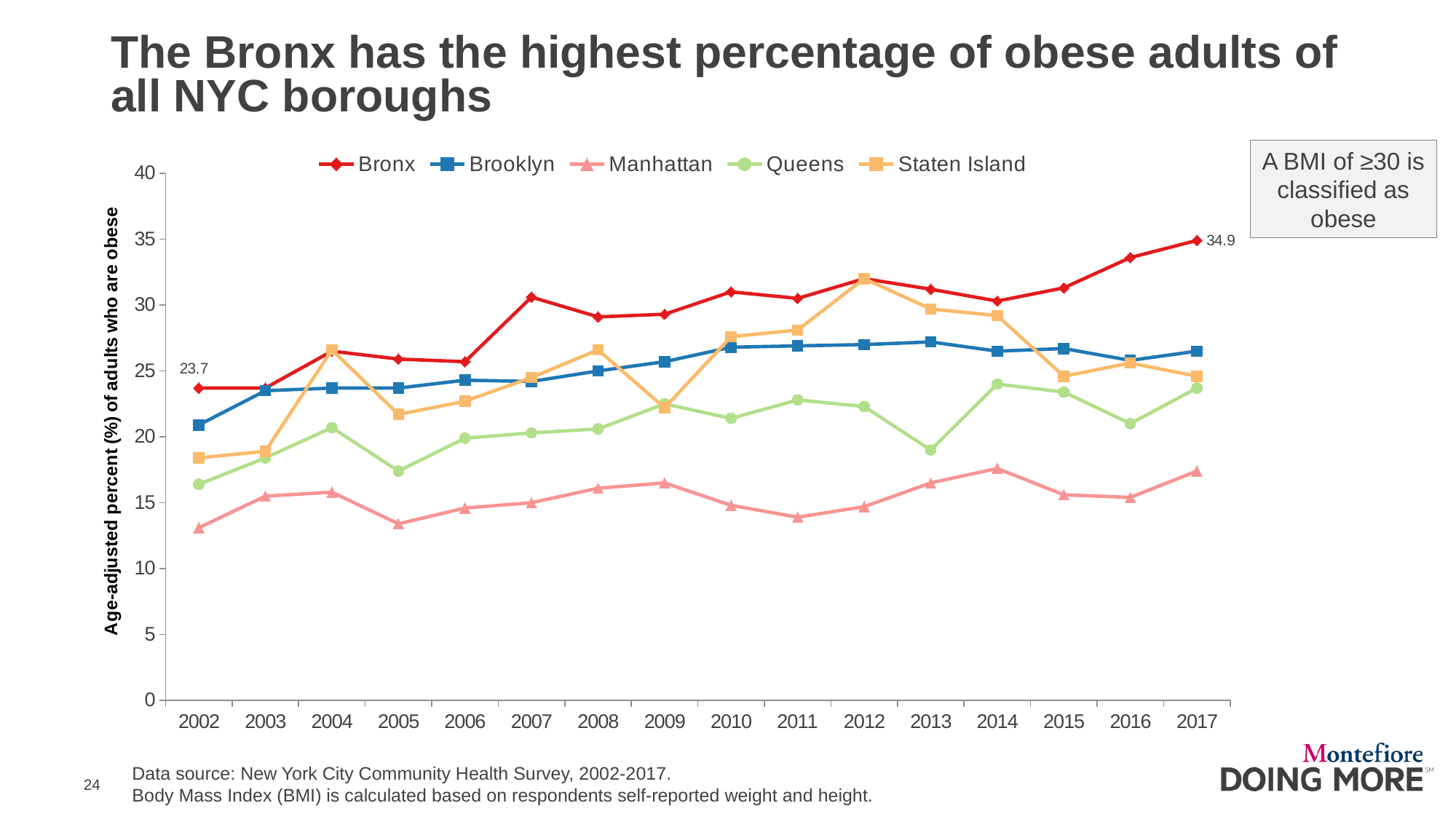
Is the value for Staten Island in 2012 greater or less than 30? greater Does the Bronx line generally rise or fall from 2002 to 2017? Rise Which borough has the highest value in 2017? Bronx Is the value for Manhattan in 2002 greater or less than 15? less What kind of chart is shown on the slide? Line chart How many years are shown on the x axis? 16 Which borough has the lowest value in 2017? Manhattan In 2004, which is larger: the value for Staten Island or the value for Queens? Staten Island What is the value for the Bronx in 2002? 23.7 By how much did the Bronx value increase from 2002 to 2017? 11.2 How many series does the legend list? 5 What is the value for the Bronx in 2017? 34.9